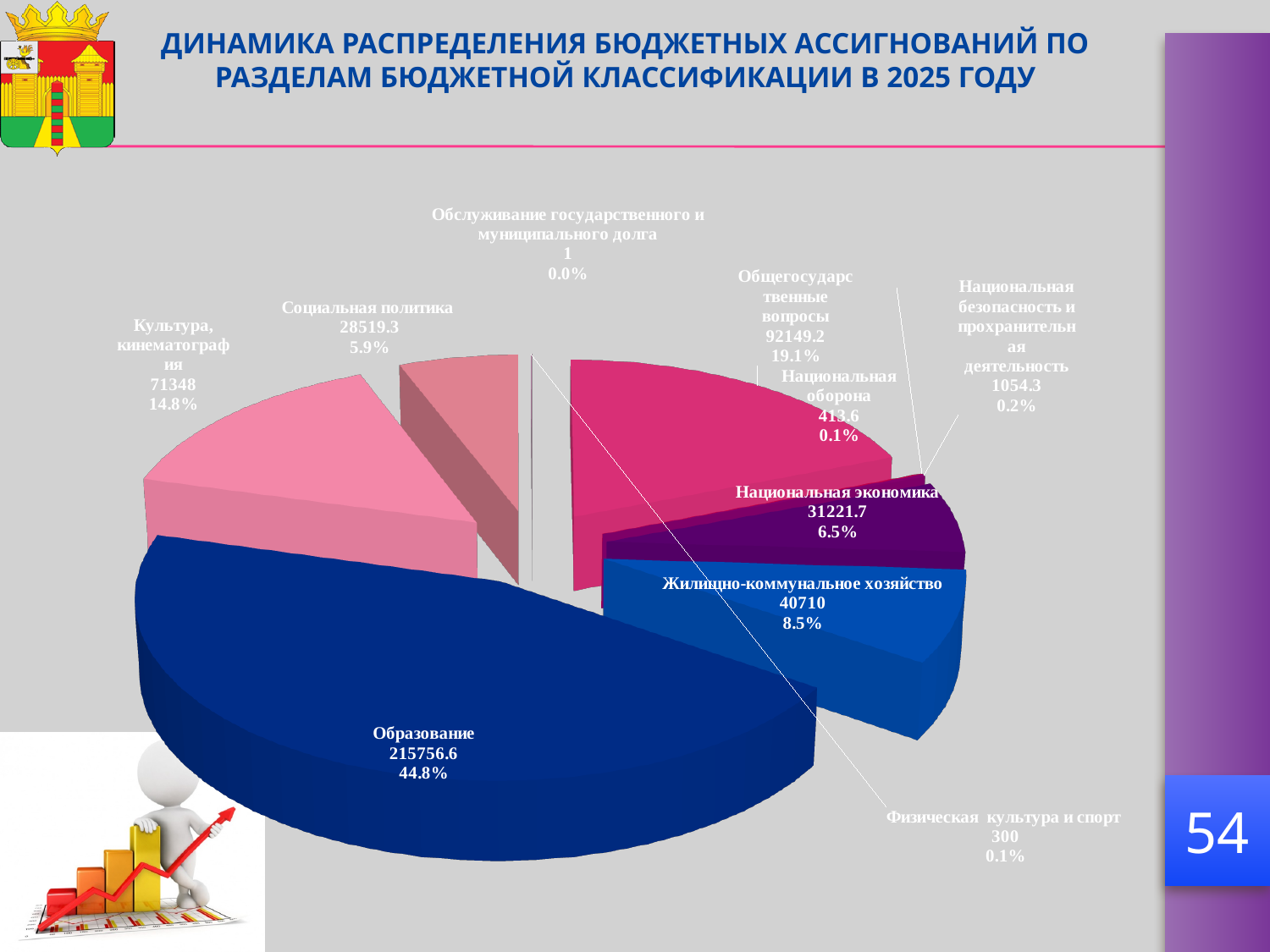
How many categories are shown in the pie chart? 10 Which category has the smallest value? Обслуживание государственного и муниципального долга Which category has the largest share of the pie? Образование What kind of chart is shown on the slide? pie chart What is the difference between the values for Жилищно-коммунальное хозяйство and Национальная экономика? 9488.3 What share of the pie does Общегосударственные вопросы have? 19.1% Which is larger, the value for Социальная политика or the value for Национальная экономика? Национальная экономика What value is shown for Жилищно-коммунальное хозяйство? 40710 What share of the pie does Культура, кинематография have? 14.8% What share of the pie does Физическая культура и спорт have? 0.1% What value is shown for Национальная безопасность и прохранительная деятельность? 1054.3 What value is shown for Образование? 215756.6